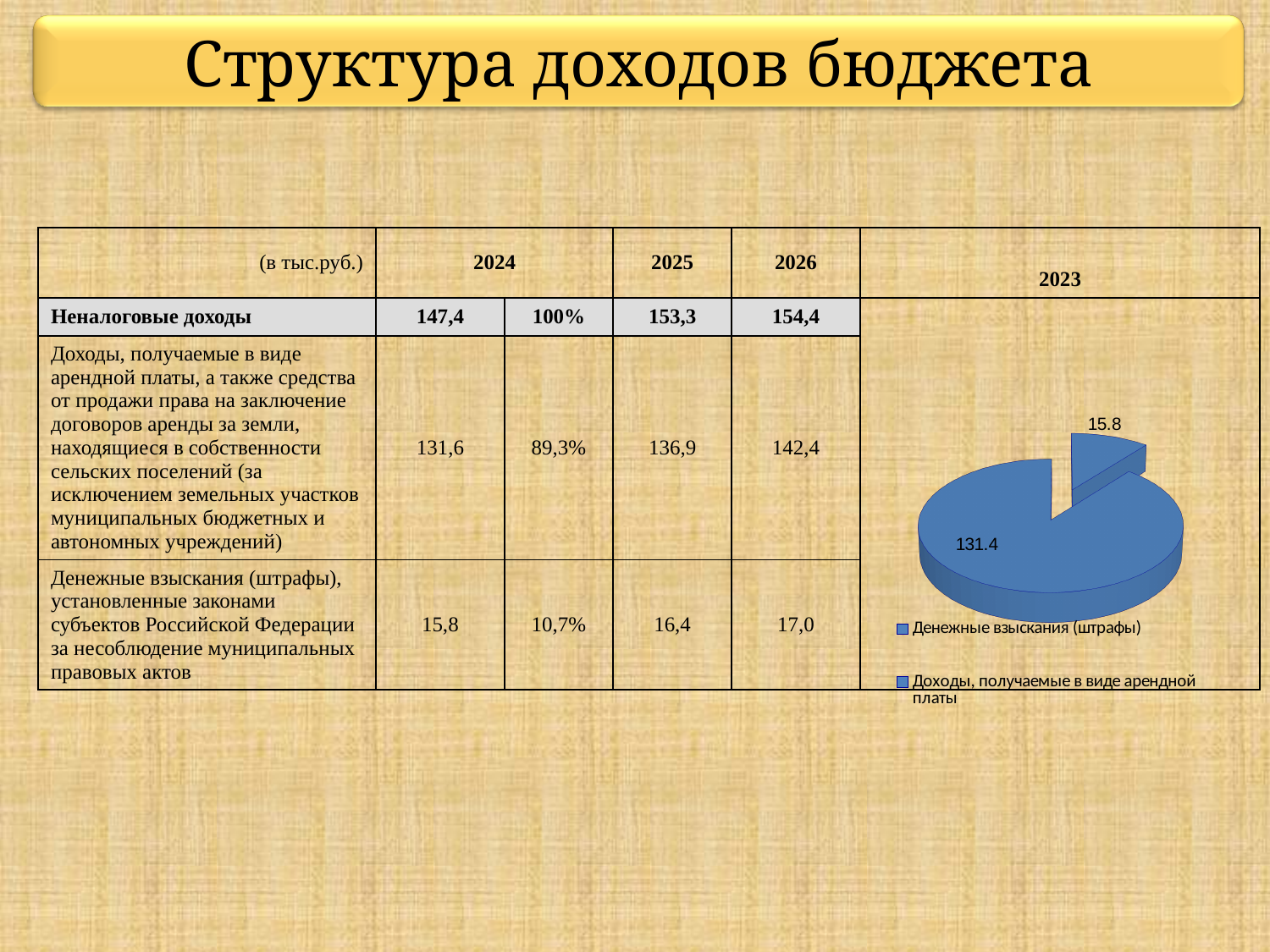
What is the title of the pie chart? 2023 How many entries does the legend of the pie chart list? 2 How many slices does the pie chart have? 2 What kind of chart is shown on the slide? pie chart What is the value of the smallest slice in the pie chart? 15.8 What share of the pie does the slice labelled 131.4 represent? 89.3% Is the exploded (pulled-out) slice of the pie chart the larger or the smaller slice? smaller What is the difference between the two slice values in the pie chart? 115.6 What is the value of the largest slice in the pie chart? 131.4 Which legend entry is listed first under the pie chart? Денежные взыскания (штрафы) What is the total of the two slices in the pie chart? 147.2 What share of the pie does the slice labelled 15.8 represent? 10.7%